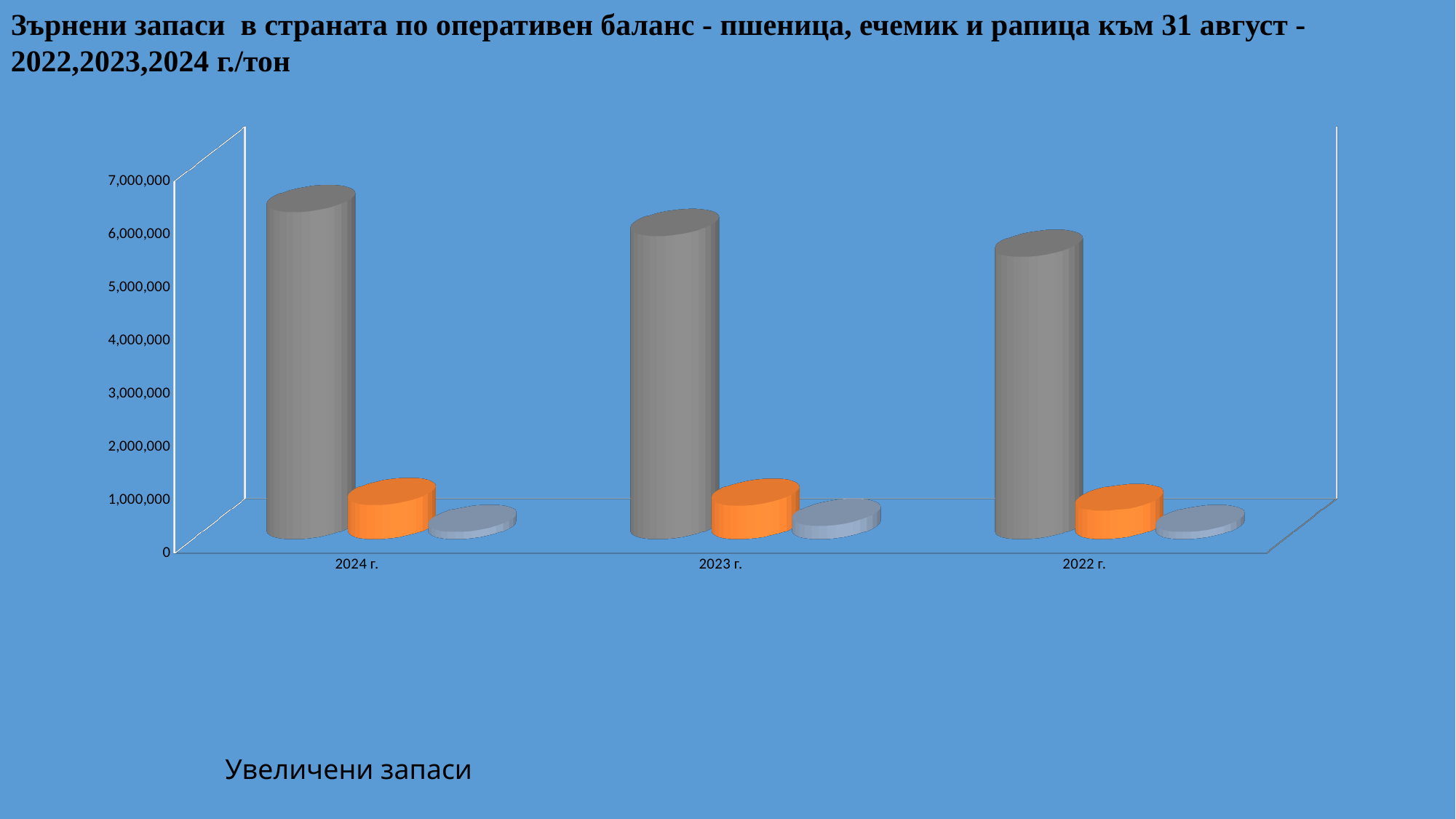
Is the value of the gray bar for 2024 г. greater or less than 5,000,000? greater How many bars are plotted for each year category? 3 Do the gray bars rise or fall moving left to right along the x axis (from 2024 г. to 2022 г.)? fall Is the value of the orange bar for 2023 г. greater or less than 2,000,000? less Is the gray bar for 2024 г. taller or shorter than the gray bar for 2022 г.? taller What colour are the tallest bars in the chart? gray What kind of chart is shown on the slide? bar chart How many year categories are shown on the x axis? 3 Is the value of the gray bar for 2022 г. greater or less than 4,000,000? greater What text appears below the chart on the slide? Увеличени запаси Which year has the tallest gray bar? 2024 г. Which year has the shortest gray bar? 2022 г.